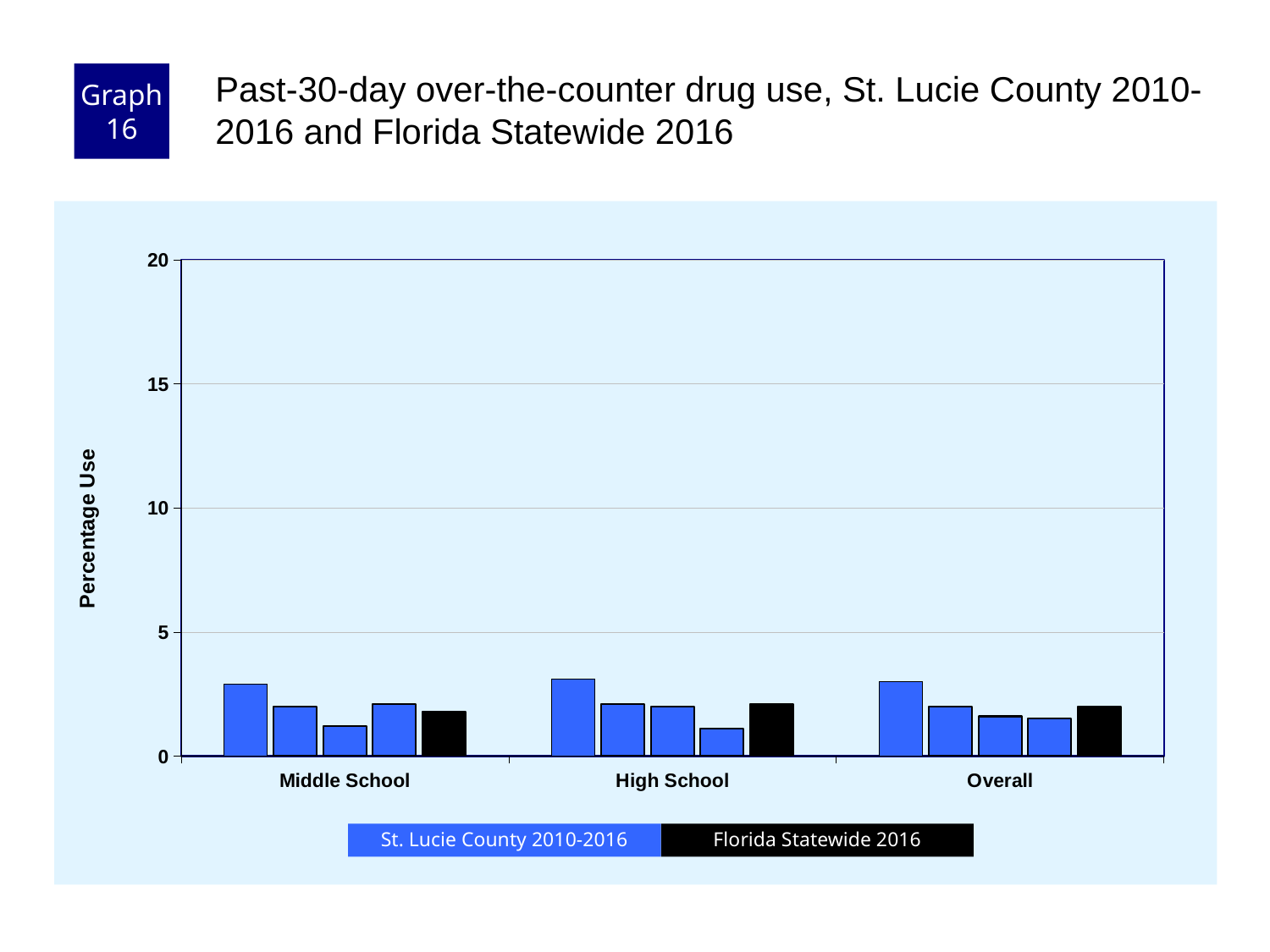
Which is larger for Overall: the tallest St. Lucie County 2010-2016 bar or the Florida Statewide 2016 bar? the tallest St. Lucie County 2010-2016 bar Is the Florida Statewide 2016 value for High School greater or less than 5? less What is the label on the y axis of the chart? Percentage Use Is the Florida Statewide 2016 value for Middle School greater or less than 10? less How many series does the chart's legend list? 2 What colour represents Florida Statewide 2016 in the chart's legend? black What kind of chart is shown on the slide? bar chart Is the Florida Statewide 2016 value for Overall greater or less than 5? less Which is larger for Middle School: the tallest St. Lucie County 2010-2016 bar or the Florida Statewide 2016 bar? the tallest St. Lucie County 2010-2016 bar How many categories are shown along the x axis of the chart? 3